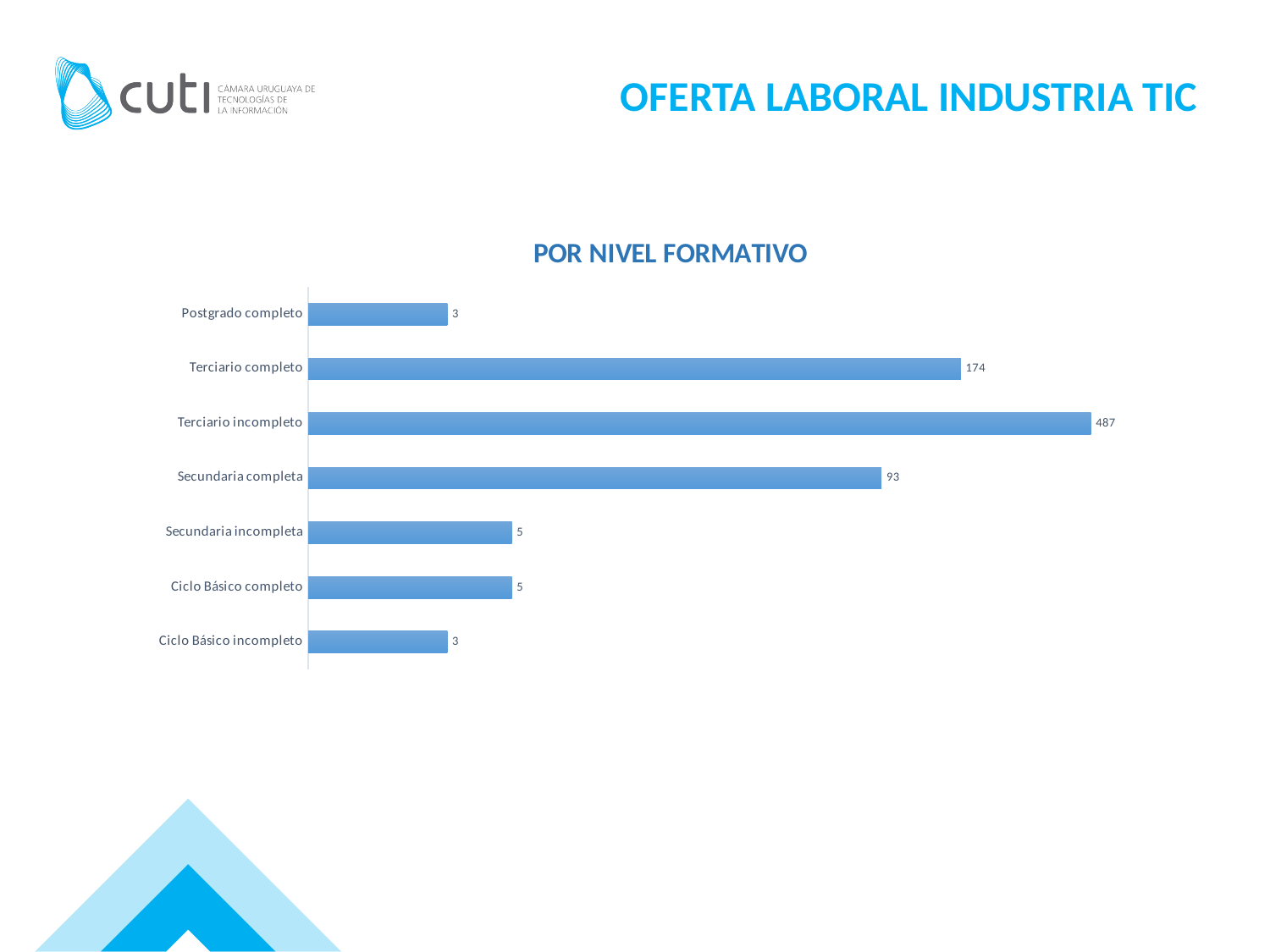
Which is larger, Terciario completo or Secundaria completa? Terciario completo What is the value for Postgrado completo? 3 What is the difference between Secundaria completa and Secundaria incompleta? 88 Which category has the highest value? Terciario incompleto What kind of chart is shown on the slide? Bar chart What is the value for Secundaria completa? 93 What is the difference between Terciario incompleto and Terciario completo? 313 What is the value for Ciclo Básico completo? 5 How many categories are shown in the chart? 7 What is the value for Terciario completo? 174 What is the value for Terciario incompleto? 487 What is the title of the chart? POR NIVEL FORMATIVO